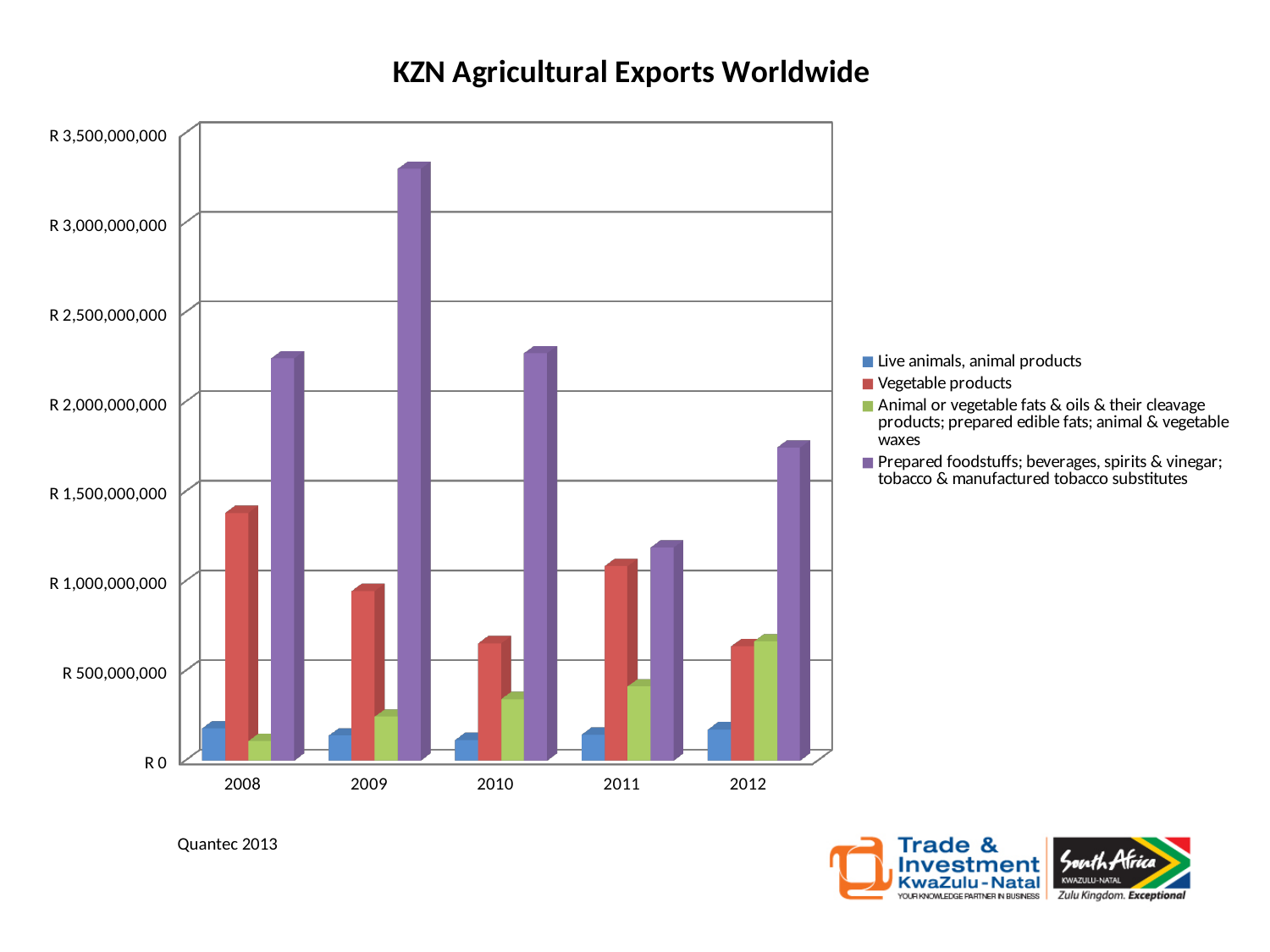
In 2011, which is larger: Vegetable products or Animal or vegetable fats & oils & their cleavage products; prepared edible fats; animal & vegetable waxes? Vegetable products In which year is the value for Vegetable products highest? 2008 Does the value for Animal or vegetable fats & oils & their cleavage products; prepared edible fats; animal & vegetable waxes rise or fall from 2008 to 2012? Rise What source is cited below the chart? Quantec 2013 Is the value for Prepared foodstuffs; beverages, spirits & vinegar; tobacco & manufactured tobacco substitutes in 2009 greater or less than R 3,000,000,000? greater Is the value for Vegetable products in 2010 greater or less than R 1,000,000,000? less In which year is the value for Prepared foodstuffs; beverages, spirits & vinegar; tobacco & manufactured tobacco substitutes highest? 2009 What is the title of the chart? KZN Agricultural Exports Worldwide How many years are shown on the x axis of the chart? 5 What kind of chart is shown on the slide? Bar chart How many series does the legend list? 4 Is the value for Vegetable products in 2008 greater or less than R 1,000,000,000? greater